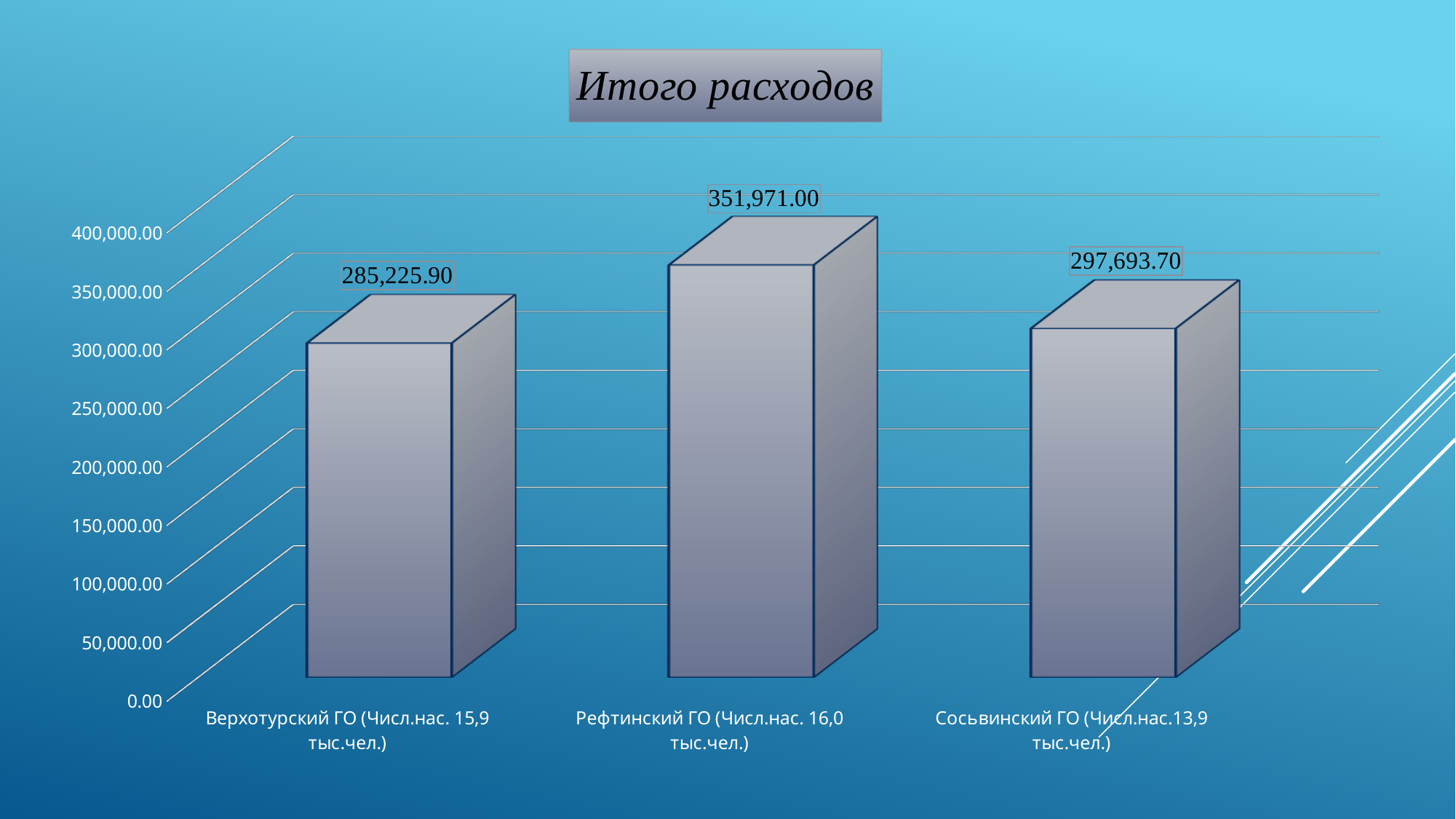
Which category has the highest value? Рефтинский ГО What is the value for Верхотурский ГО? 285,225.90 What is the difference between the values for Сосьвинский ГО and Верхотурский ГО? 12,467.80 What is the title of the chart? Итого расходов Which category has the lowest value? Верхотурский ГО What is the value for Рефтинский ГО? 351,971.00 Which is larger, the value for Сосьвинский ГО or Верхотурский ГО? Сосьвинский ГО What is the difference between the values for Рефтинский ГО and Верхотурский ГО? 66,745.10 What kind of chart is shown on the slide? bar chart What is the value for Сосьвинский ГО? 297,693.70 Is the value for Рефтинский ГО greater or less than 300,000.00? greater How many categories are shown in the chart? 3